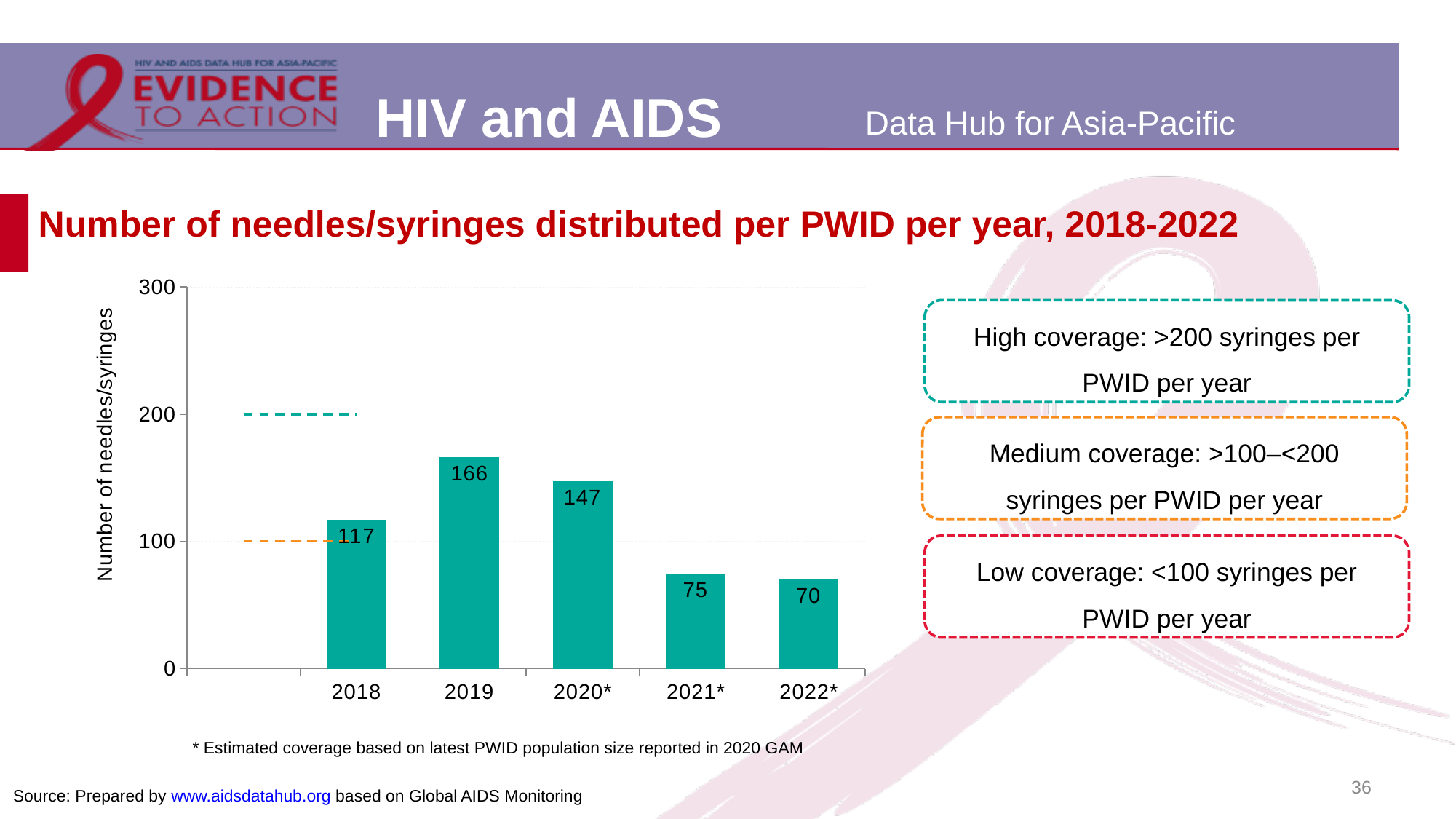
What kind of chart is shown on the slide? bar chart What is the difference between the values for 2018 and 2021*? 42 Which is larger, the value for 2020* or the value for 2021*? 2020* What is the difference between the values for 2019 and 2020*? 19 What is the value shown for 2022*? 70 Which year has the highest number of needles/syringes distributed per PWID? 2019 Do the values rise or fall from 2019 to 2022*? fall How many years are shown on the x axis of the chart? 5 What is the value shown for 2018? 117 Is the value for 2019 greater or less than 200? less Which year has the lowest number of needles/syringes distributed per PWID? 2022* What is the number of needles/syringes distributed per PWID in 2019? 166